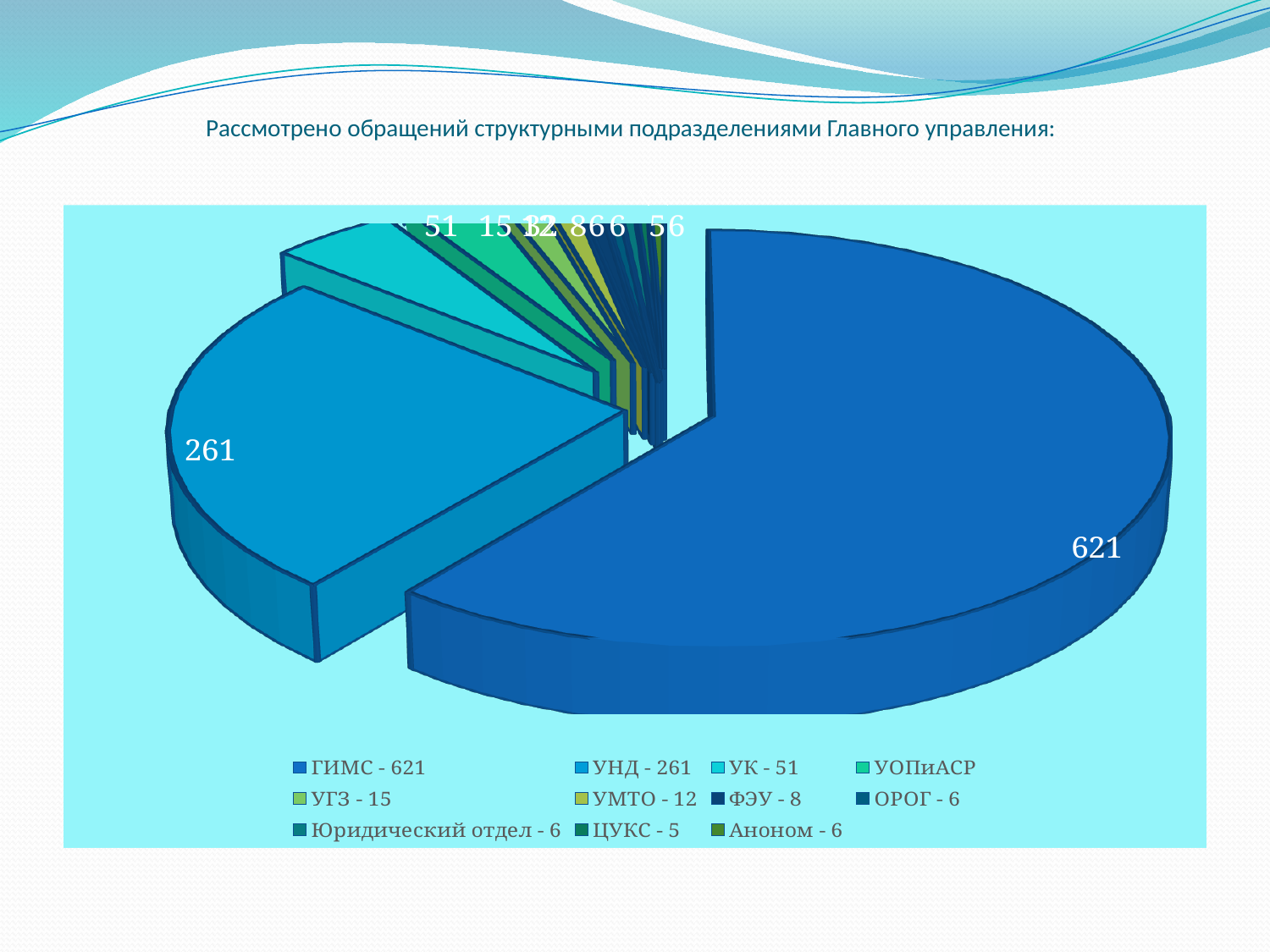
What is the difference between the values for ГИМС and УНД? 360 What is the value for УК? 51 What is the value for УНД? 261 Which category has the largest slice of the pie? ГИМС Which is larger, the value for УК or the value for УМТО? УК What is the value for ФЭУ? 8 What is the value for ЦУКС? 5 What kind of chart is shown on the slide? pie chart How many categories does the legend list? 11 What is the value for ГИМС? 621 What is the value for УГЗ? 15 What is the title of the slide above the chart? Рассмотрено обращений структурными подразделениями Главного управления: